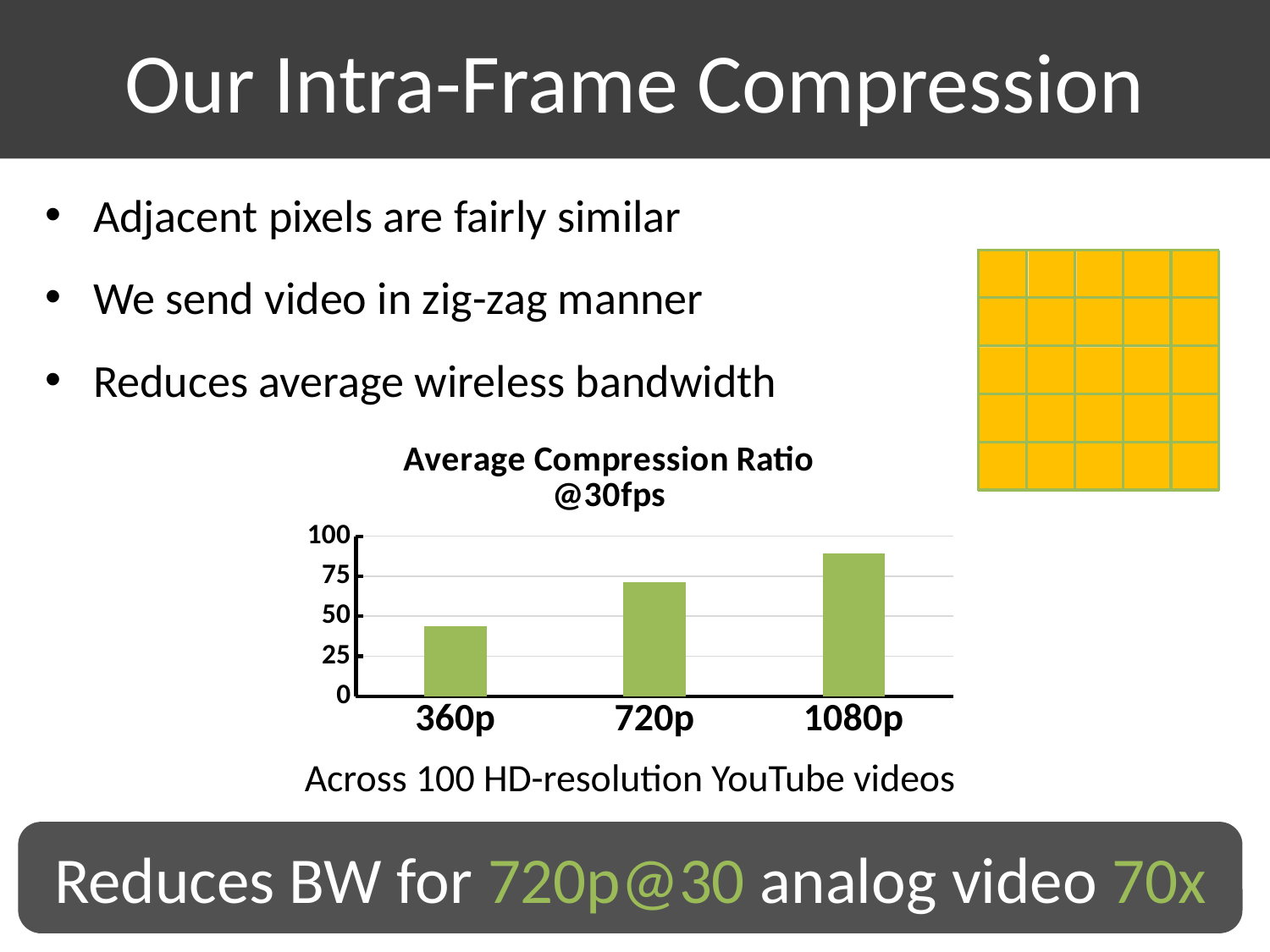
Which has a larger average compression ratio, 1080p or 720p? 1080p Which resolution has the highest average compression ratio? 1080p What is the title of the chart? Average Compression Ratio @30fps Is the value for 720p greater or less than 50? greater Which resolution has the lowest average compression ratio? 360p Which has a larger average compression ratio, 720p or 360p? 720p Do the values rise or fall as resolution increases from 360p to 1080p? rise How many categories are plotted on the x axis of the chart? 3 What is the highest value shown on the chart's y axis? 100 Is the value for 360p greater or less than 50? less What kind of chart is shown on the slide? bar chart Is the value for 1080p greater or less than 75? greater